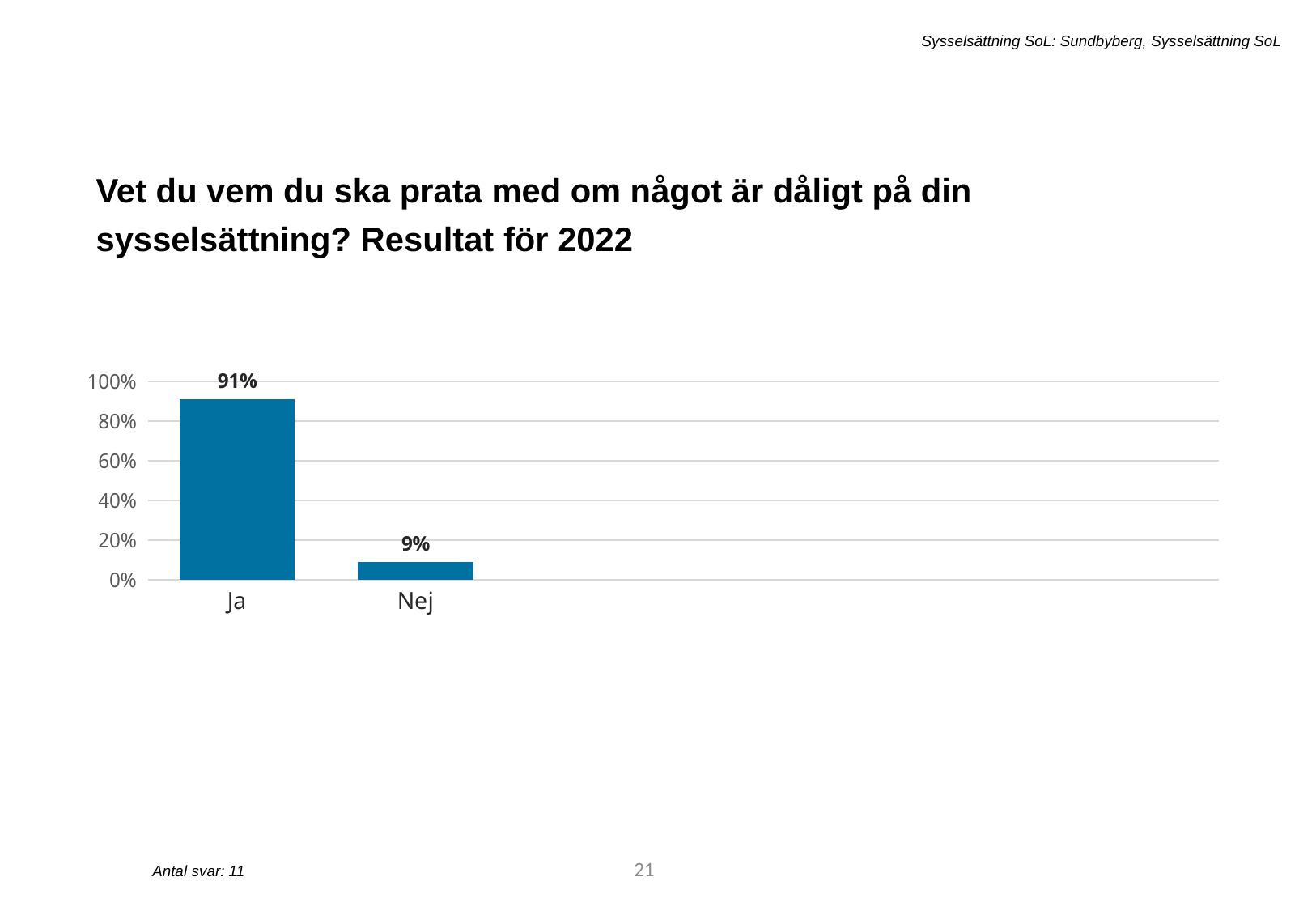
What is the value for Nej? 9% What is the difference between the values for Ja and Nej? 82% What kind of chart is shown on the slide? bar chart Which category has the lowest value? Nej What is the highest value shown on the y axis? 100% Is the value for Nej greater or less than 20%? less How many responses (Antal svar) does the slide report? 11 Which category has the highest value? Ja How many categories are shown on the x axis? 2 Which is larger, the value for Ja or the value for Nej? Ja What is the value for Ja? 91% Is the value for Ja greater or less than 80%? greater